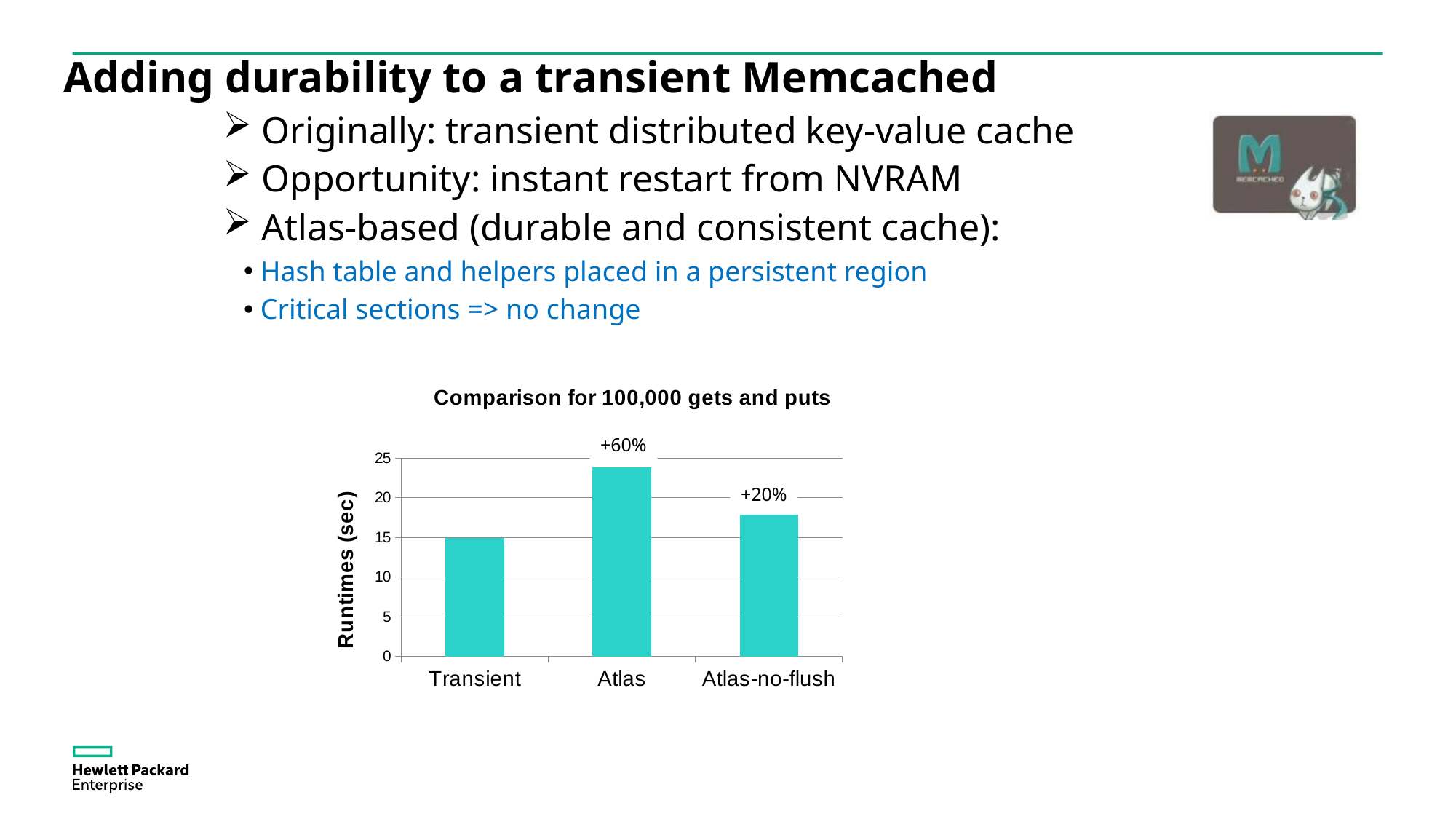
What percentage label is printed above the Atlas-no-flush bar? +20% What percentage label is printed above the Atlas bar? +60% Is the runtime for Atlas greater or less than 20 seconds? greater What is the title of the chart? Comparison for 100,000 gets and puts Which has a larger runtime, Atlas or Atlas-no-flush? Atlas Which configuration has the lowest runtime in the chart? Transient How many bars are plotted in the chart? 3 Is the runtime for Atlas-no-flush greater or less than 20 seconds? less What type of chart is shown on the slide? bar chart Is the runtime for Transient greater or less than 20 seconds? less Which configuration has the highest runtime in the chart? Atlas What is the label of the vertical axis of the chart? Runtimes (sec)